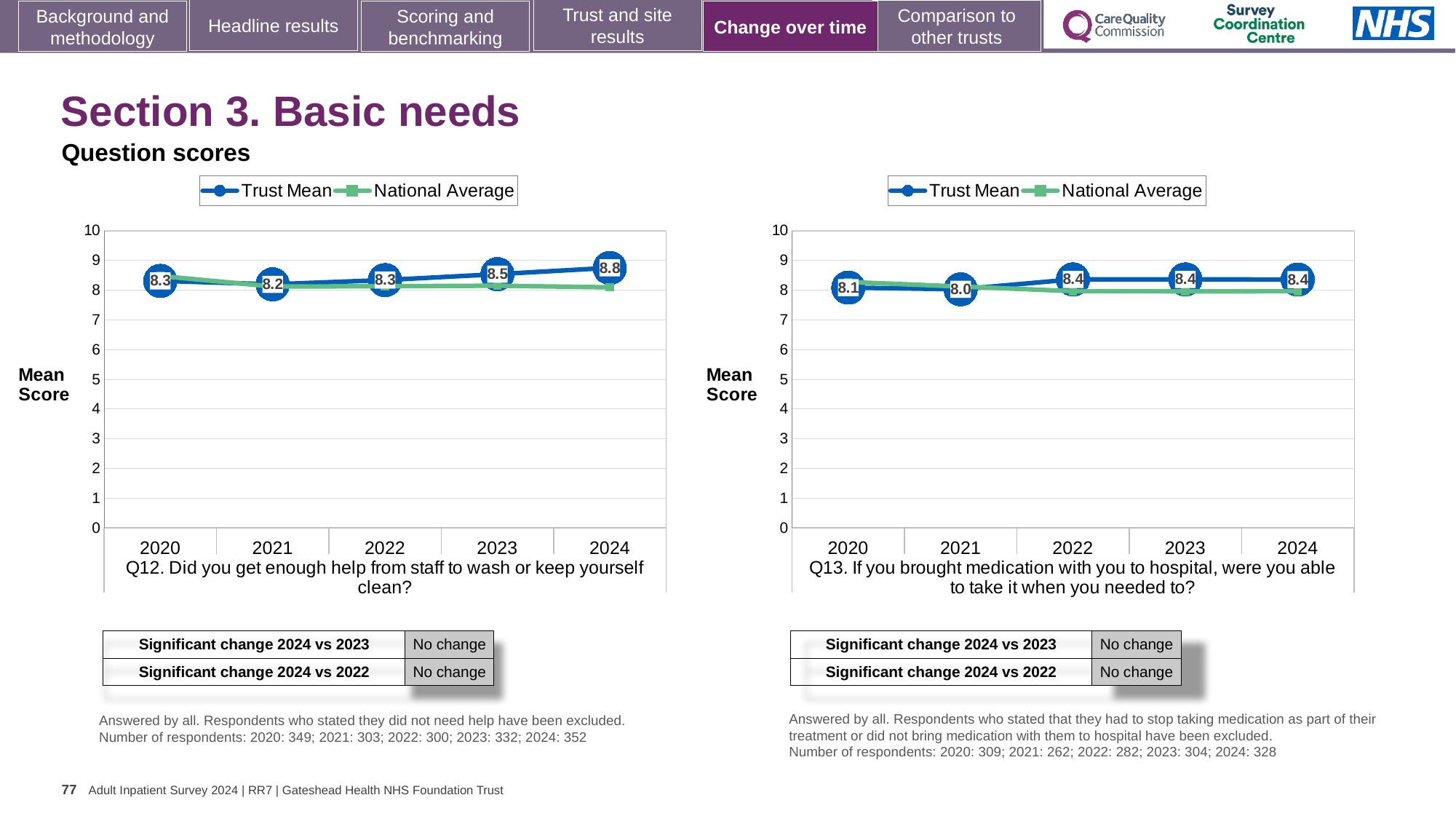
What kind of chart is the Q12 chart (left)? Line chart In the Q12 chart (left), what is the Trust Mean for 2021? 8.2 How many series does the legend of the Q13 chart (right) list? 2 In the Q12 chart (left), is the National Average for 2024 greater or less than 7? greater In the Q12 chart (left), which year has the highest Trust Mean? 2024 In the Q13 chart (right), what is the Trust Mean for 2022? 8.4 In the Q13 chart (right), which is larger, the Trust Mean for 2020 or for 2022? 2022 In the Q12 chart (left), what is the Trust Mean for 2024? 8.8 How many years are shown on the x axis of the Q12 chart (left)? 5 In the Q13 chart (right), which year has the lowest Trust Mean? 2021 In the Q13 chart (right), what is the Trust Mean for 2020? 8.1 In the Q12 chart (left), what is the difference between the Trust Mean for 2024 and 2023? 0.3